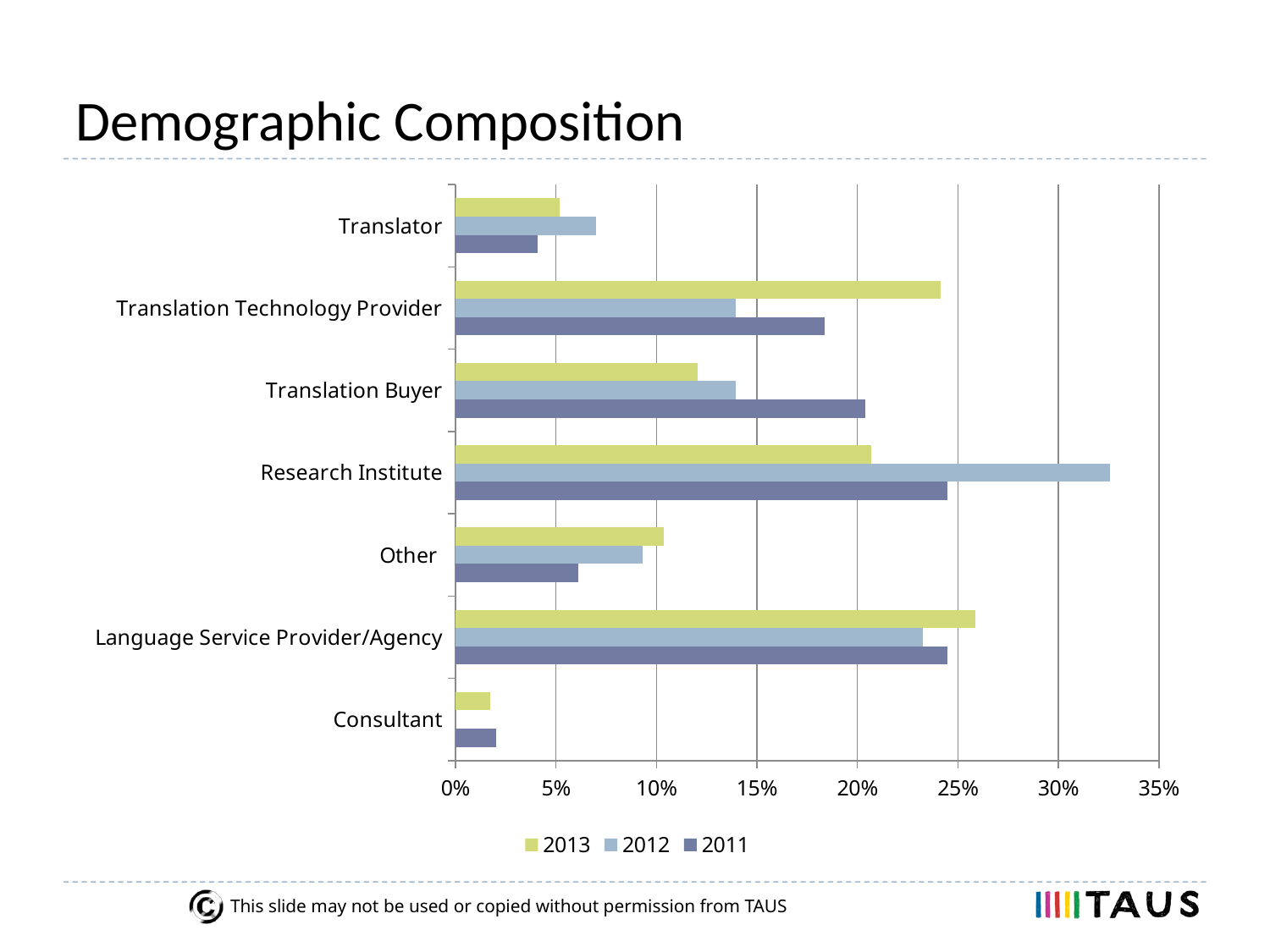
What kind of chart is shown on the slide? Bar chart How many series does the legend list? 3 For Translation Buyer, which series has the larger value, 2011 or 2013? 2011 Which category has the highest value for the 2012 series? Research Institute Is the 2012 value for Research Institute greater or less than 30%? greater For Translation Technology Provider, which series has the larger value, 2013 or 2012? 2013 Which category has the highest value for the 2013 series? Language Service Provider/Agency How many categories are shown on the vertical axis? 7 What is the title of the slide containing the chart? Demographic Composition Which category has the lowest value for the 2011 series? Consultant Is the 2013 value for Translation Technology Provider greater or less than 20%? greater Is the 2011 value for Other greater or less than 10%? less